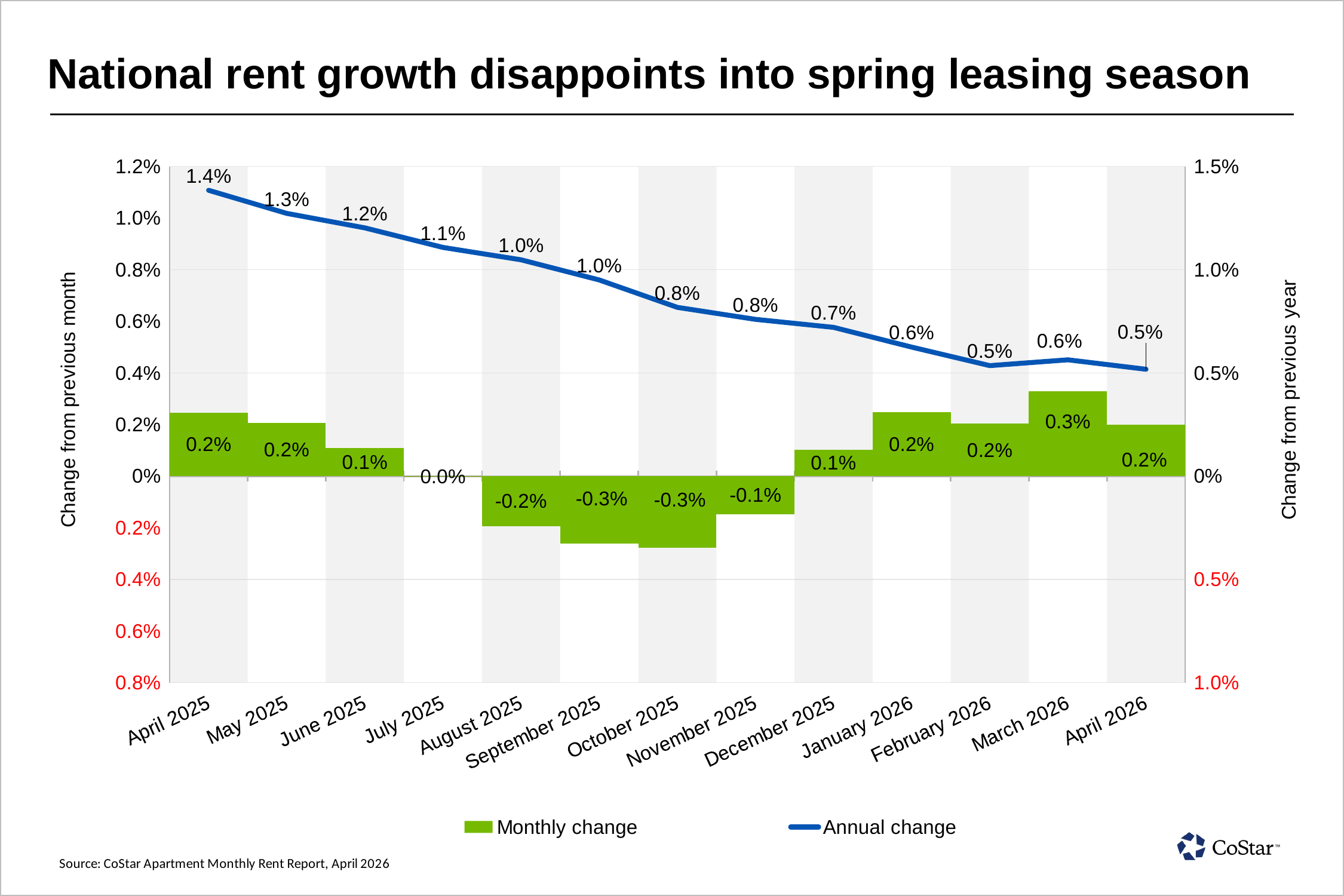
What is the monthly change for March 2026? 0.3% Which is larger, the monthly change for March 2026 or for June 2025? March 2026 What kind of chart is this? Combination bar and line chart What is the annual change for April 2026? 0.5% By how many percentage points did the annual change fall from April 2025 to April 2026? 0.9 percentage points Which month has the highest annual change? April 2025 Does the annual change generally rise or fall from April 2025 to April 2026? Fall What is the monthly change for September 2025? -0.3% How many series does the legend list? 2 How many months are shown on the x axis? 13 What is the annual change for April 2025? 1.4% Which month has the highest monthly change? March 2026